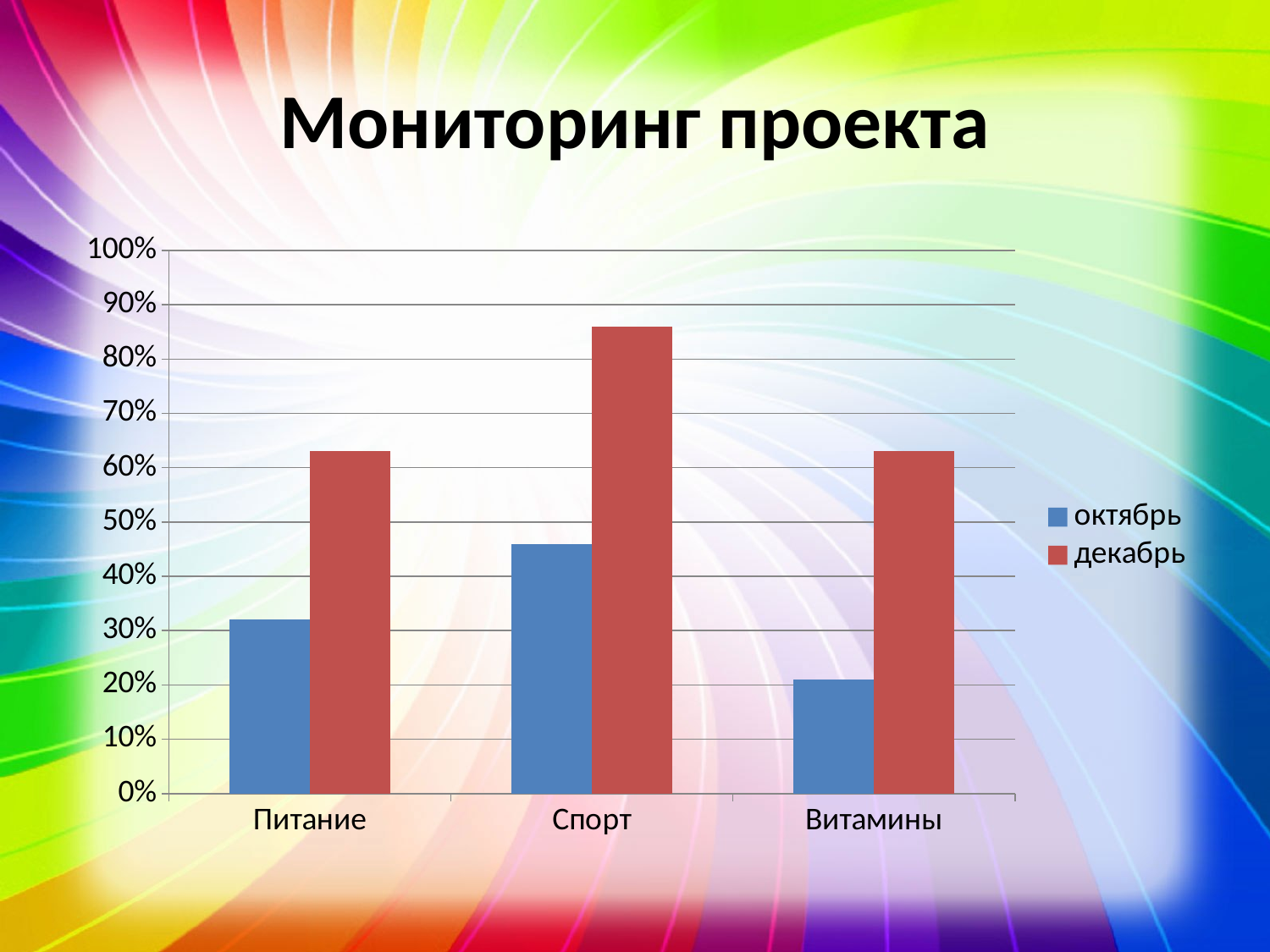
Is the value for Питание in декабрь greater or less than 60%? greater How many series does the legend list? 2 What kind of chart is shown on the slide? bar chart Which category has the lowest value for октябрь? Витамины Is the value for Спорт in декабрь greater or less than 80%? greater Which is larger for Питание: the value for октябрь or the value for декабрь? декабрь Which category has the highest value for октябрь? Спорт How many categories are shown on the x axis? 3 What is the title of the slide? Мониторинг проекта Which category has the highest value for декабрь? Спорт Which colour represents the series октябрь in the legend? blue Is the value for Витамины in октябрь greater or less than 30%? less